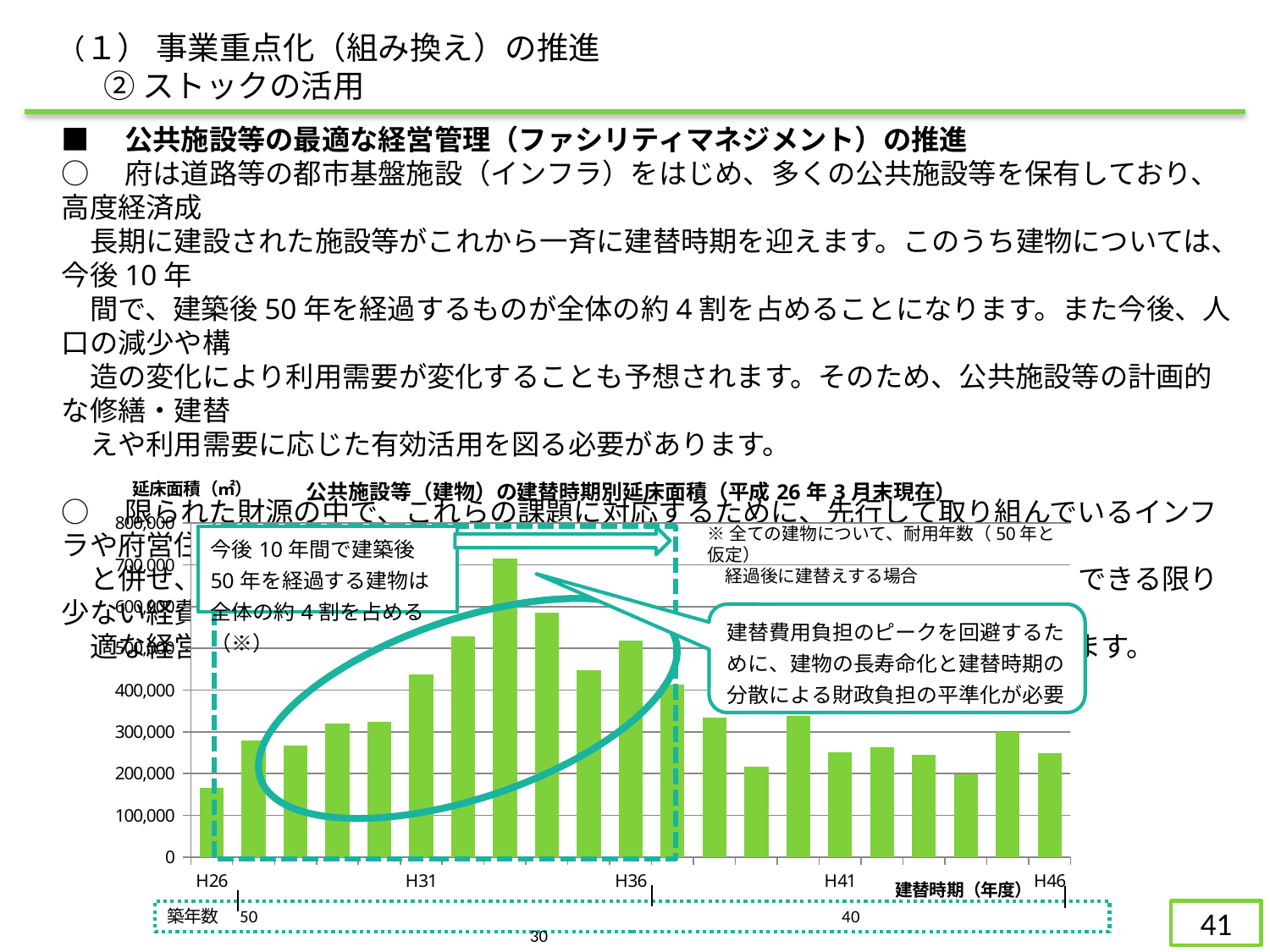
Is the value for H26 greater or less than 200,000? less Which is larger, the value for H26 or the value for H46? H46 What is the label of the vertical axis of the chart? 延床面積（㎡） Which year has the lowest bar in the chart? H26 How many bars are plotted in the chart? 21 What is the title of the chart? 公共施設等（建物）の建替時期別延床面積（平成26年3月末現在） Is the value for H31 greater or less than 400,000? greater Which is larger, the value for H31 or the value for H36? H36 Is the value for H41 greater or less than 300,000? less What kind of chart is shown on the slide? bar chart Do the values generally rise or fall from H26 to H31? rise